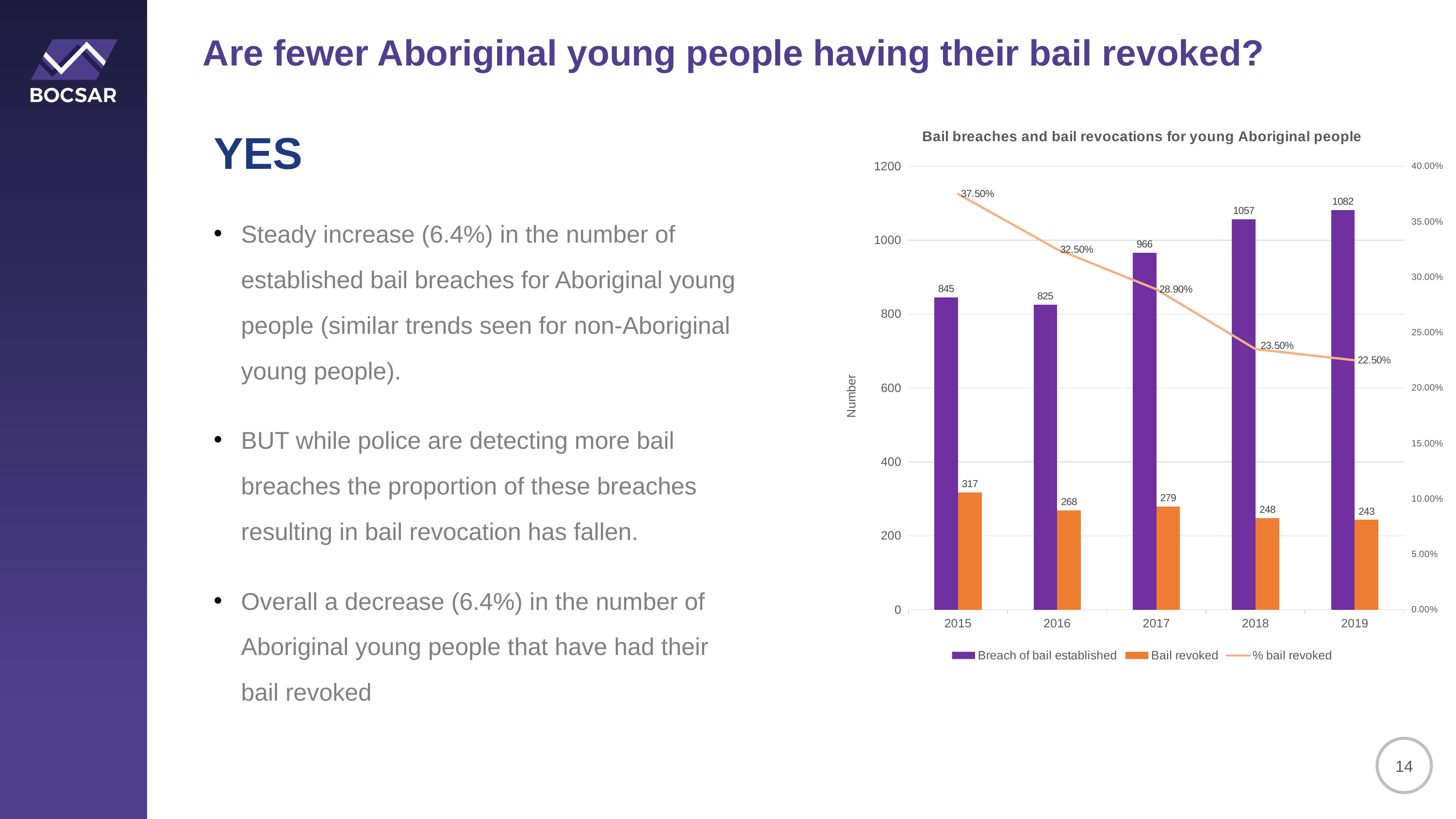
What is the value for Bail revoked in 2015? 317 What is the difference between Breach of bail established in 2019 and in 2015? 237 How many series does the legend list? 3 Which is larger: Bail revoked in 2016 or Bail revoked in 2017? 2017 Is the value for Breach of bail established in 2018 greater or less than 1000? greater What is the value for Breach of bail established in 2017? 966 How many years are shown on the x axis? 5 Does the % bail revoked line rise or fall from 2015 to 2019? fall Which year has the lowest value for Bail revoked? 2019 Which year has the highest value for Breach of bail established? 2019 What is the title of the chart? Bail breaches and bail revocations for young Aboriginal people What is the % bail revoked in 2019? 22.50%